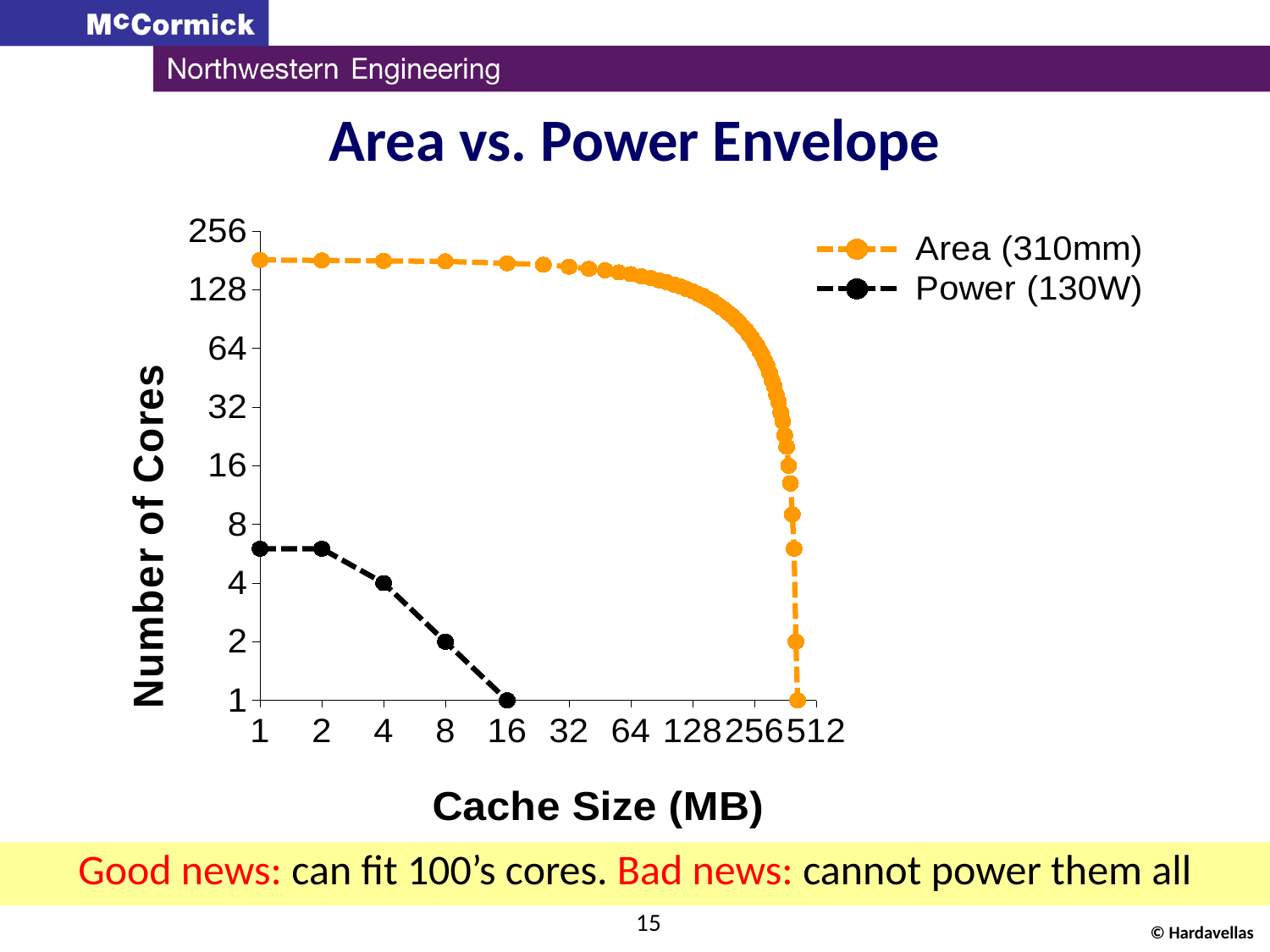
Is the Area (310mm) value at a cache size of 1 MB greater or less than 128? greater Does the Power (130W) series rise or fall as cache size increases? fall What is the label of the x axis? Cache Size (MB) How many cores does the Power (130W) series show at a cache size of 16 MB? 1 How many cores does the Power (130W) series show at a cache size of 4 MB? 4 What kind of chart is shown on the slide? line chart How many series does the legend list? 2 At a cache size of 4 MB, which series shows more cores, Area (310mm) or Power (130W)? Area (310mm) Is the Power (130W) value at a cache size of 1 MB greater or less than 8? less How many data points are plotted for the Power (130W) series? 5 What are the two series named in the legend? Area (310mm) and Power (130W) How many cores does the Power (130W) series show at a cache size of 8 MB? 2